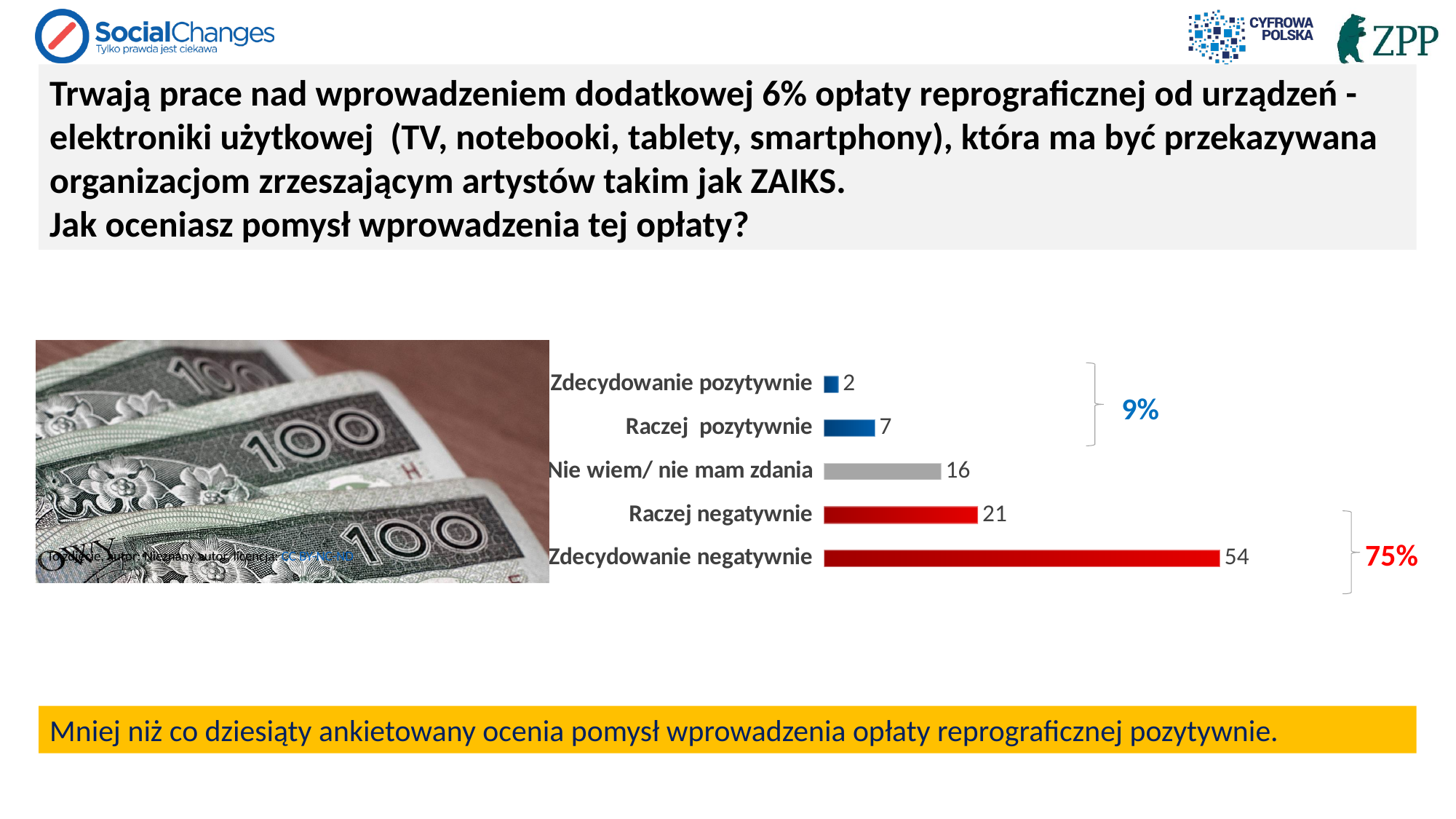
What is the value for "Raczej negatywnie"? 21 What kind of chart is shown on the slide? Bar chart What is the value for "Raczej pozytywnie"? 7 Which category has the lowest value? Zdecydowanie pozytywnie What is the value for "Zdecydowanie pozytywnie"? 2 Which is larger, the value for "Nie wiem/ nie mam zdania" or the value for "Raczej pozytywnie"? Nie wiem/ nie mam zdania Which category has the highest value? Zdecydowanie negatywnie How many categories are shown in the chart? 5 What combined percentage is shown next to the bracket grouping the two negative categories? 75% What is the value for "Zdecydowanie negatywnie"? 54 What is the value for "Nie wiem/ nie mam zdania"? 16 What is the difference between the values for "Zdecydowanie negatywnie" and "Raczej negatywnie"? 33